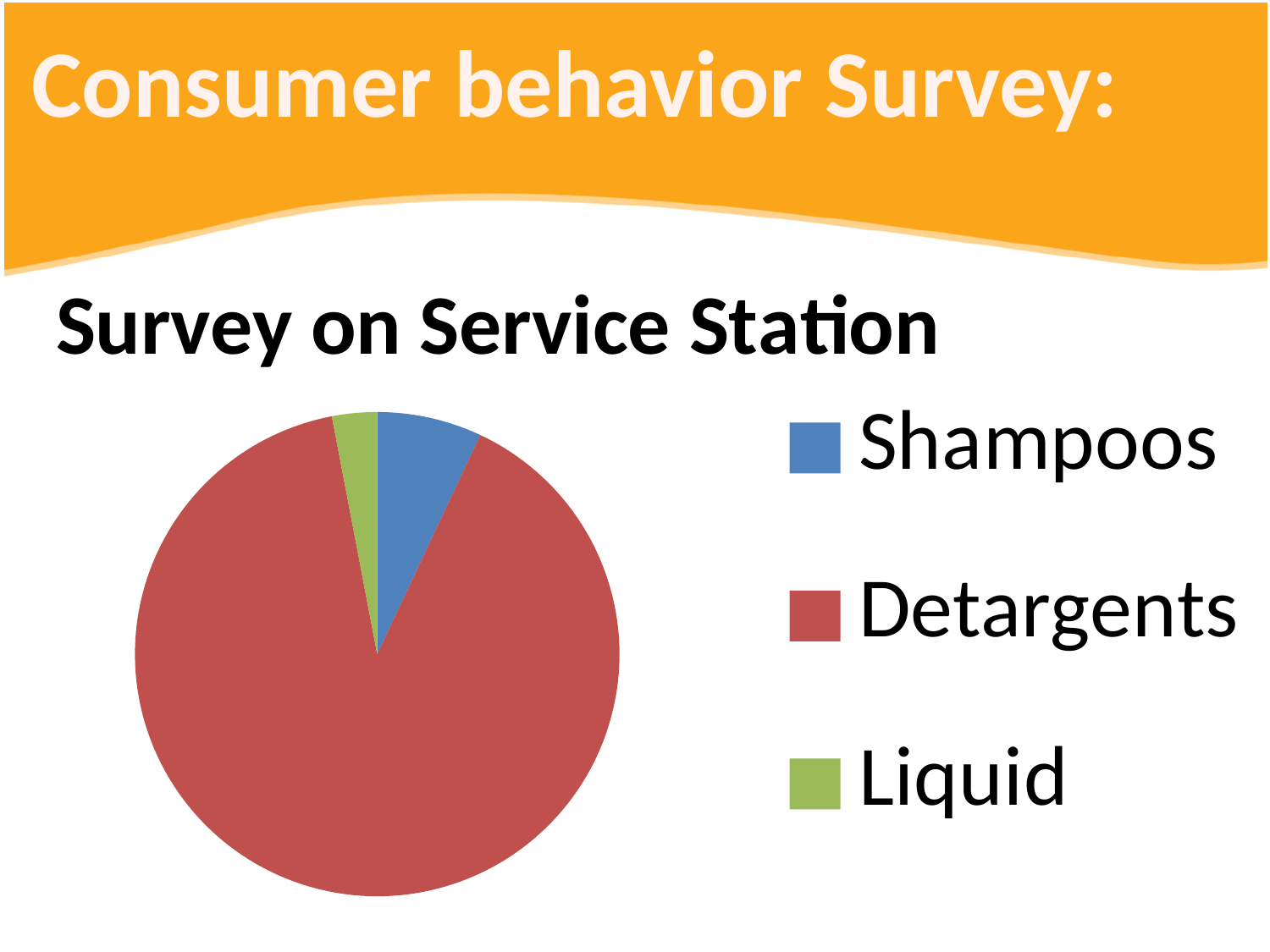
What is the title shown above the pie chart? Survey on Service Station Which slice is larger, Shampoos or Liquid? Shampoos What kind of chart is shown on the slide? pie chart Which category has the smallest slice of the pie chart? Liquid How many categories does the legend of the pie chart list? 3 Which slice is larger, Detargents or Shampoos? Detargents Is the Detargents slice more or less than half of the pie? more Which category has the largest slice of the pie chart? Detargents What colour is the Detargents slice in the pie chart? red